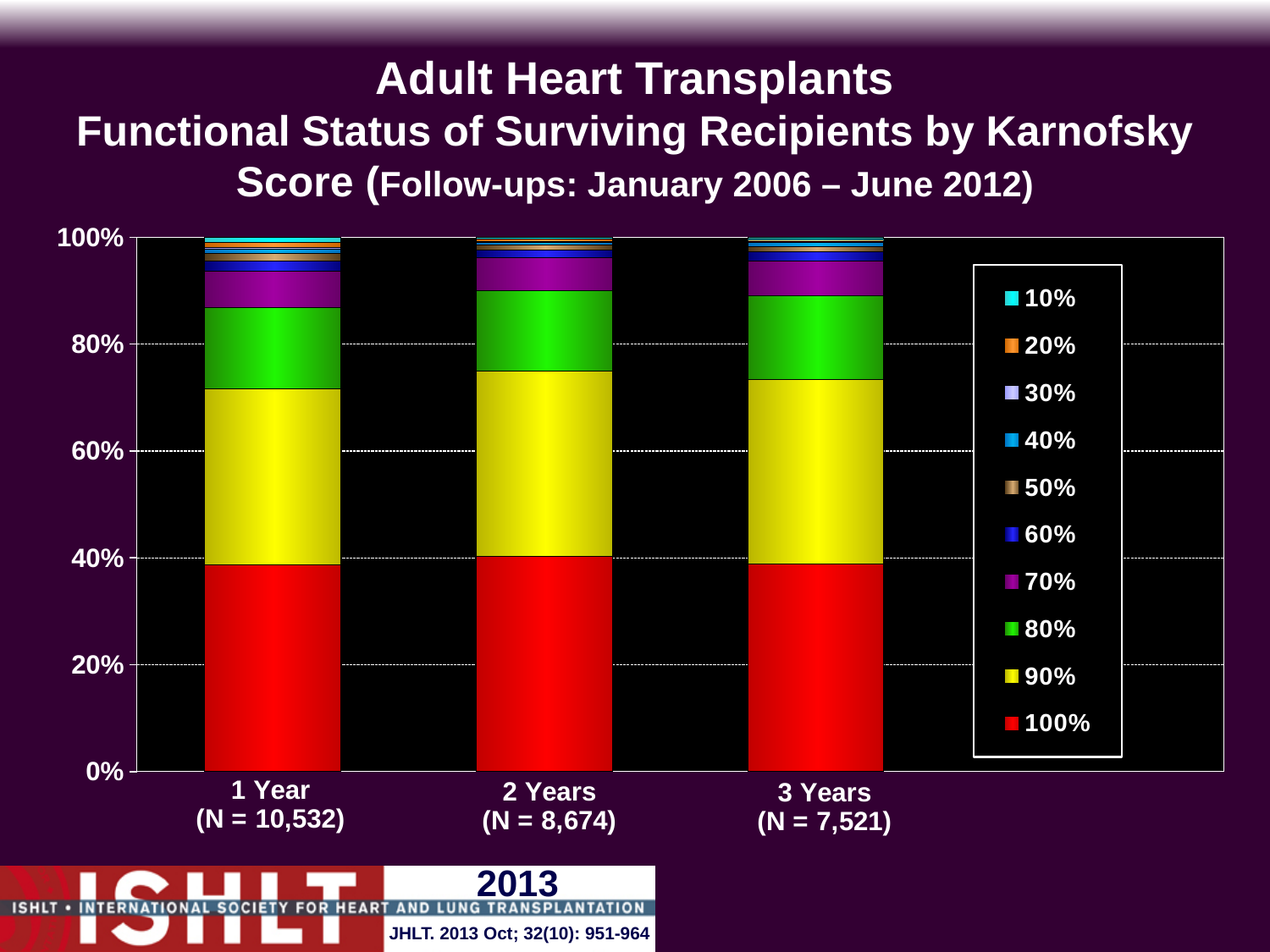
How many categories (follow-up time points) are shown on the x axis? 3 Is the share of the 100% Karnofsky score segment for 3 Years greater or less than 40%? less Is the cumulative top of the 80% segment for 3 Years greater or less than 80%? greater Is the cumulative top of the 90% segment for 1 Year greater or less than 60%? greater Which Karnofsky score segment is the largest in the 1 Year bar? 100% How many series does the legend list? 10 What is the N value shown for the 1 Year category? N = 10,532 What is the N value shown for the 3 Years category? N = 7,521 What kind of chart is shown on the slide? Stacked bar chart What is the total of the stacked bar for 2 Years? 100%